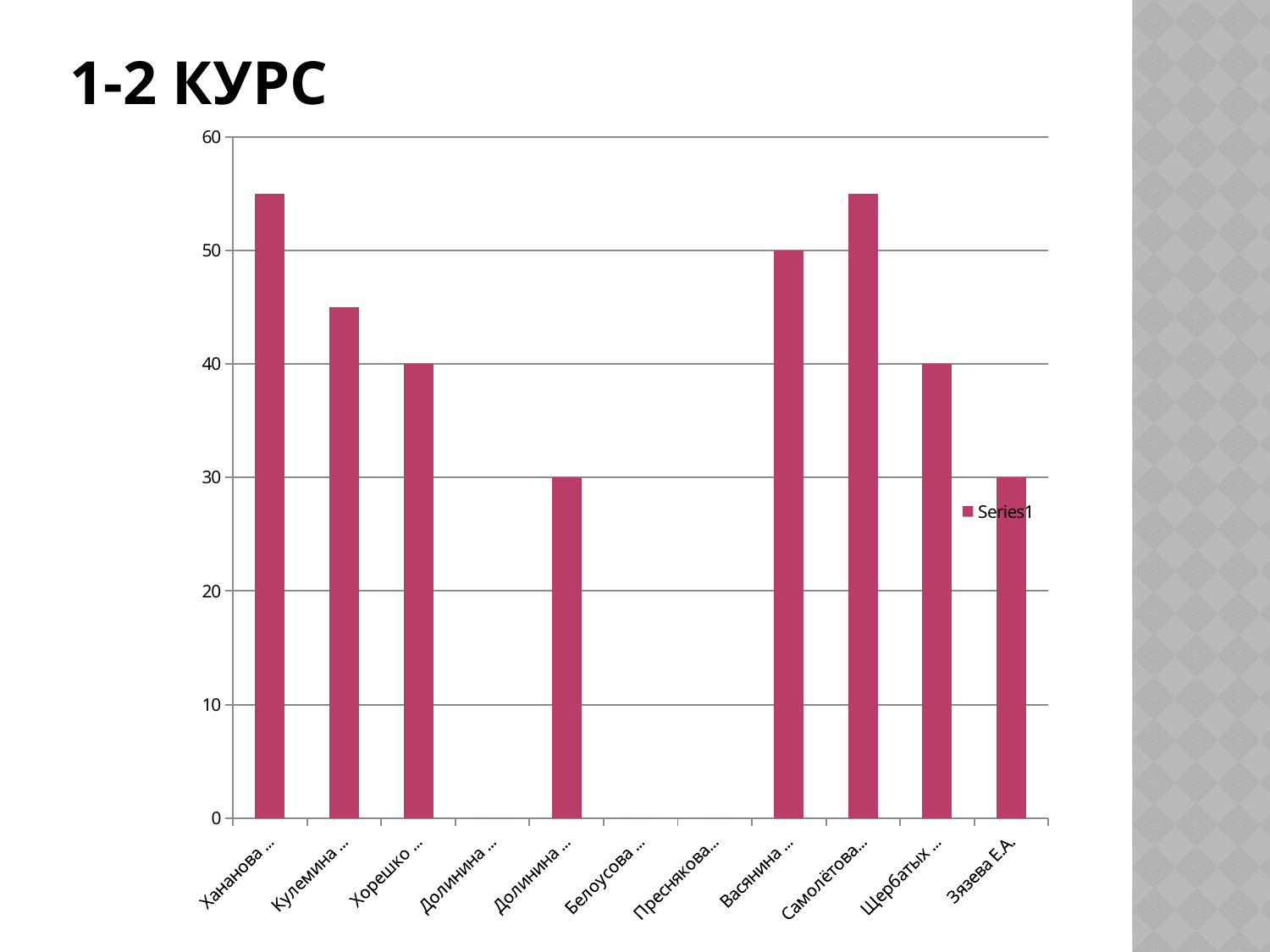
Is the value for Кулемина greater or less than 50? less What is the value for Васянина? 50 What type of chart is shown on the slide? bar chart What is the name of the series shown in the legend? Series1 Which is larger, the value for Васянина or the value for Хорешко? Васянина What is the value for Щербатых? 40 How many categories are shown along the x axis of the chart? 11 What is the value for Зязева Е.А.? 30 How many series does the chart legend list? 1 Is the value for Хананова greater or less than 50? greater What is the value for Хорешко? 40 What is the difference between the values for Васянина and Хорешко? 10